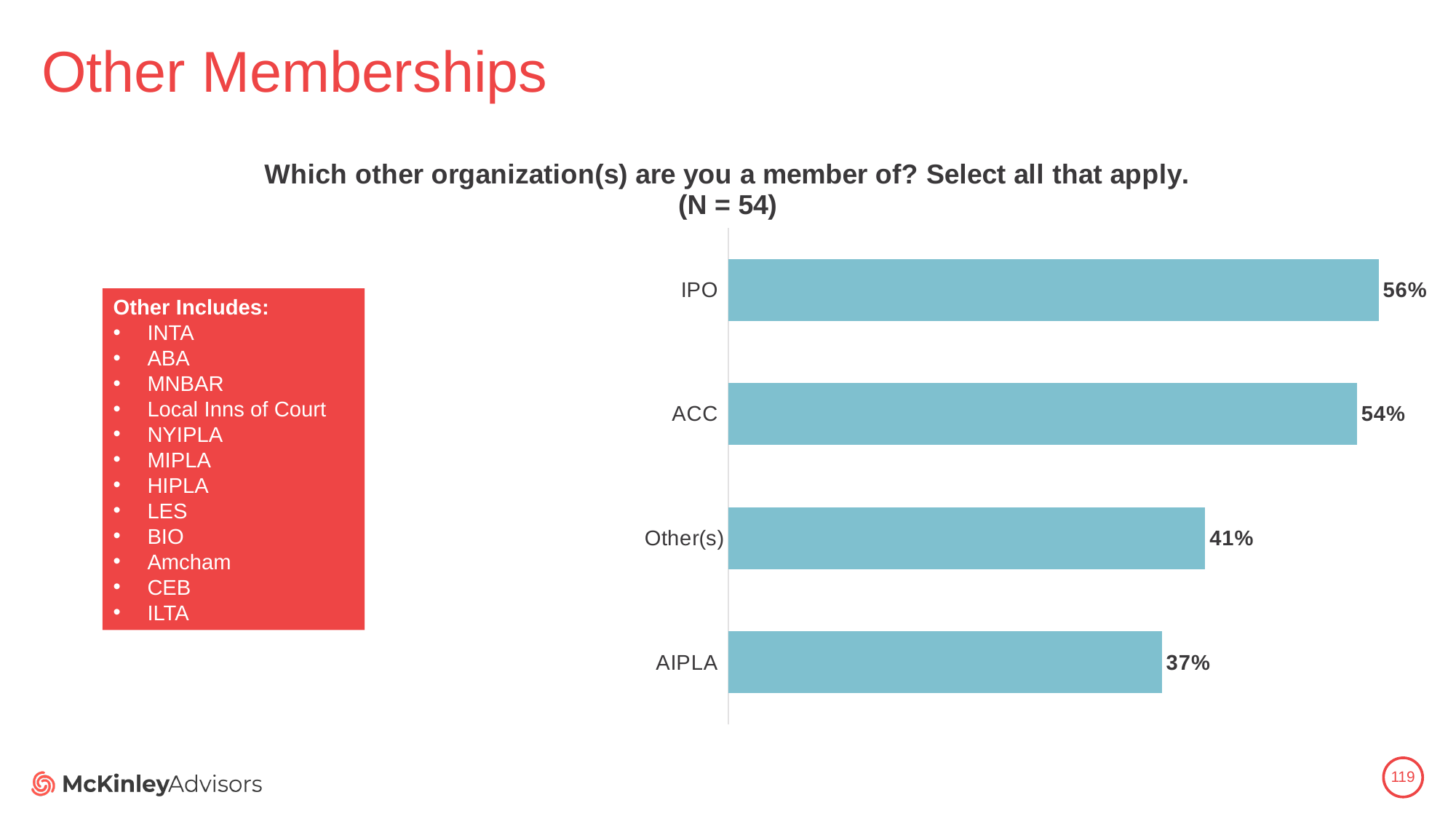
Which organization has the lowest share of respondents as members? AIPLA What percentage of respondents are members of ACC? 54% What percentage of respondents are members of AIPLA? 37% What is the difference in percentage points between ACC and Other(s)? 13 Which has a larger share of respondents, Other(s) or AIPLA? Other(s) How many organization categories are shown in the chart? 4 Which organization has the highest share of respondents as members? IPO What is the difference in percentage points between IPO and AIPLA? 19 What is the sample size (N) stated in the chart title? 54 What percentage of respondents selected Other(s)? 41% What kind of chart is shown on the slide? Bar chart What percentage of respondents are members of IPO? 56%